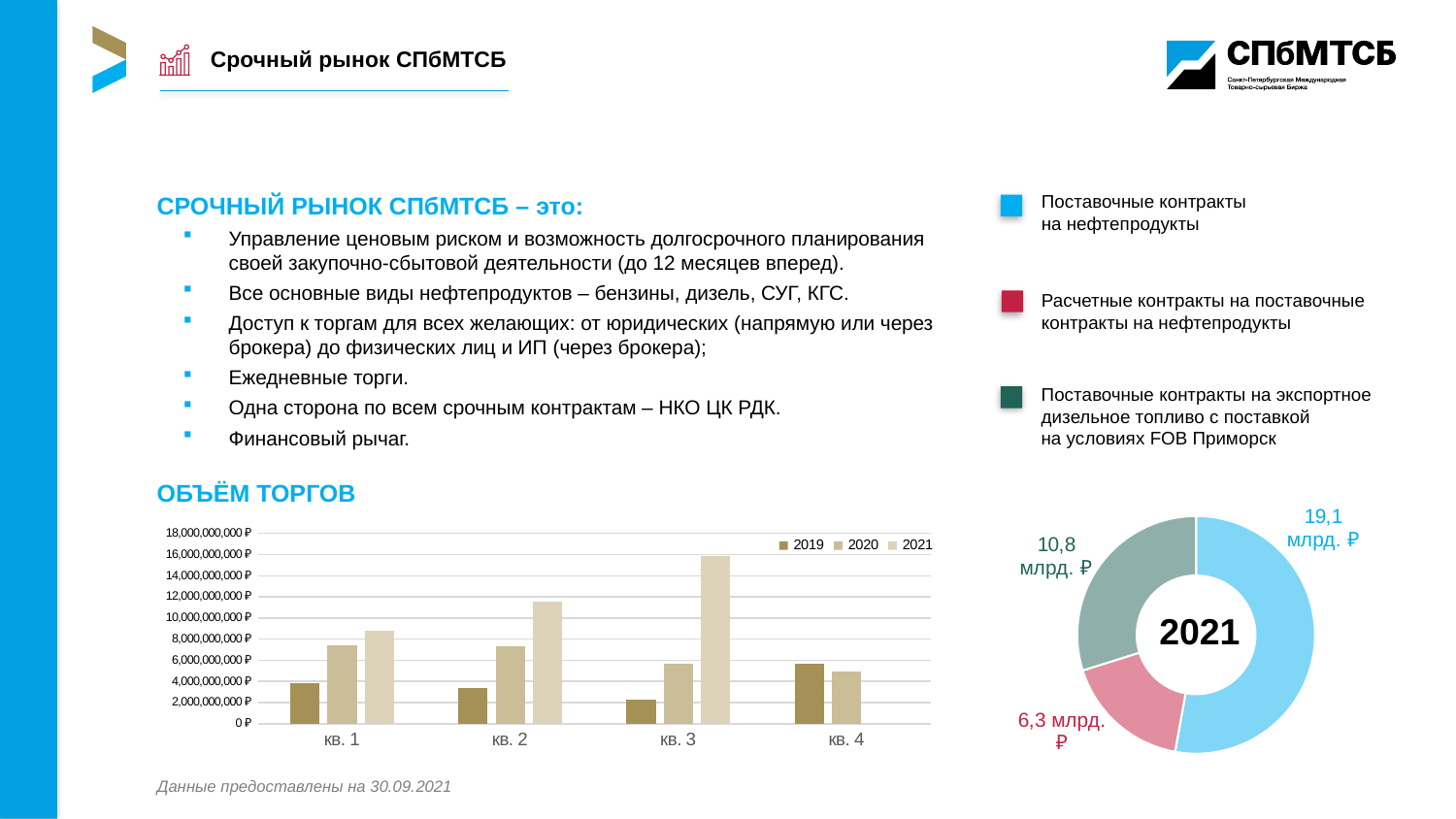
In the "ОБЪЁМ ТОРГОВ" bar chart, do the 2021 values rise or fall from кв. 1 to кв. 3? Rise In the donut chart on the right, what is the total of the three segments? 36,2 млрд. ₽ What kind of chart is the "ОБЪЁМ ТОРГОВ" chart on the left? Bar chart In the "ОБЪЁМ ТОРГОВ" bar chart, is the 2019 value for кв. 3 greater or less than 4,000,000,000 ₽? less What year is shown in the centre of the donut chart on the right? 2021 In the donut chart on the right, what is the value for Расчетные контракты на поставочные контракты на нефтепродукты? 6,3 млрд. ₽ In the "ОБЪЁМ ТОРГОВ" bar chart, how many quarters are shown on the x axis? 4 In the donut chart on the right, what is the value for Поставочные контракты на нефтепродукты? 19,1 млрд. ₽ In the "ОБЪЁМ ТОРГОВ" bar chart, which is larger for кв. 1: the 2019 value or the 2020 value? 2020 In the "ОБЪЁМ ТОРГОВ" bar chart, is the 2021 value for кв. 3 greater or less than 14,000,000,000 ₽? greater In the "ОБЪЁМ ТОРГОВ" bar chart, how many series does the legend list? 3 In the "ОБЪЁМ ТОРГОВ" bar chart, which quarter has the highest 2021 value? кв. 3